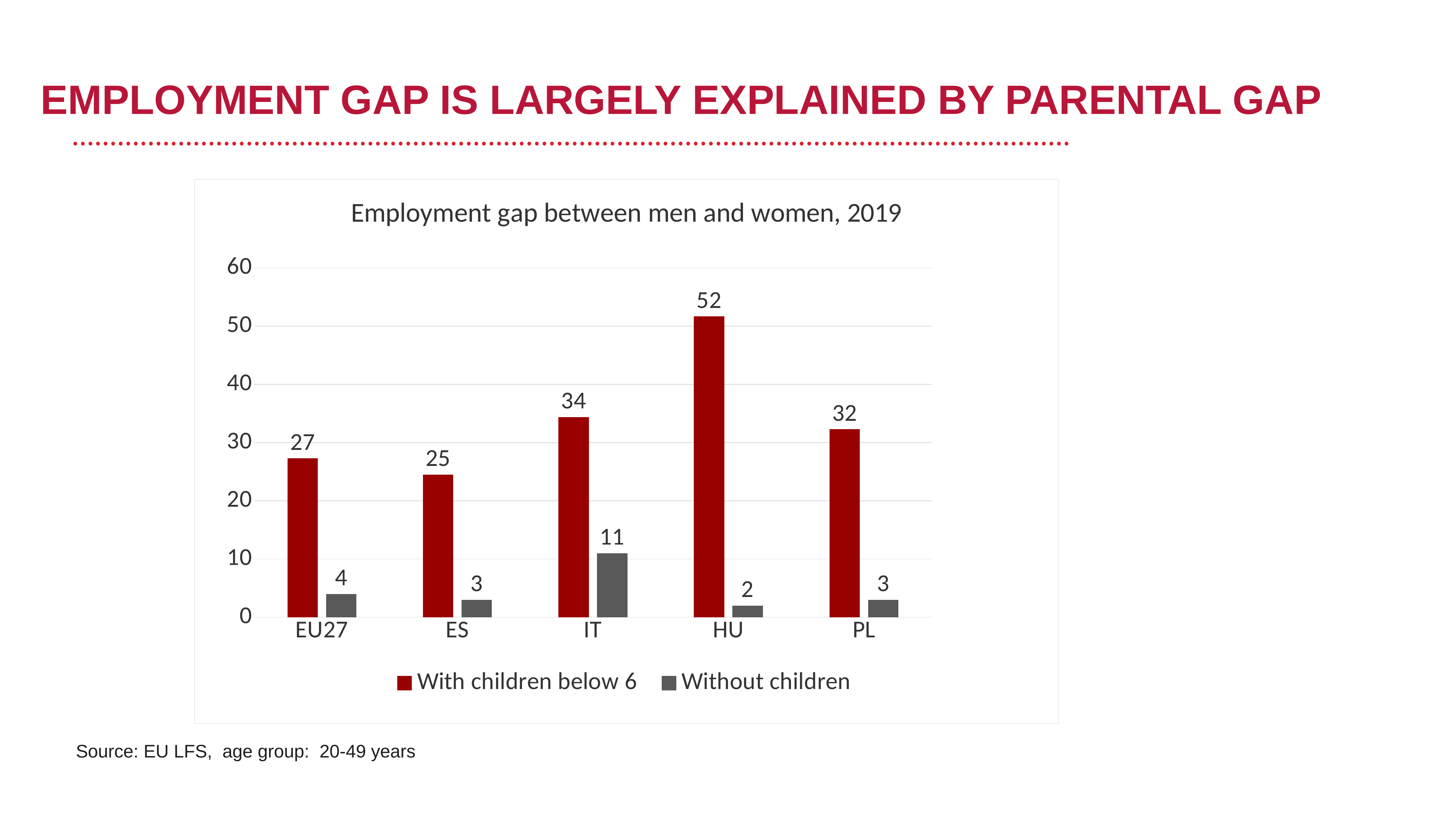
What is the employment gap for EU27 with children below 6? 27 What is the employment gap for HU with children below 6? 52 Which country has the highest employment gap with children below 6? HU Which is larger: the employment gap with children below 6 for IT or for ES? IT What is the title of the chart? Employment gap between men and women, 2019 How many series does the legend list? 2 What kind of chart is shown on the slide? Bar chart Is the value for HU with children below 6 greater or less than 50? greater What is the difference between the employment gap with children below 6 and without children for PL? 29 Which category has the lowest employment gap without children? HU What is the employment gap for IT without children? 11 How many categories are shown on the x axis? 5